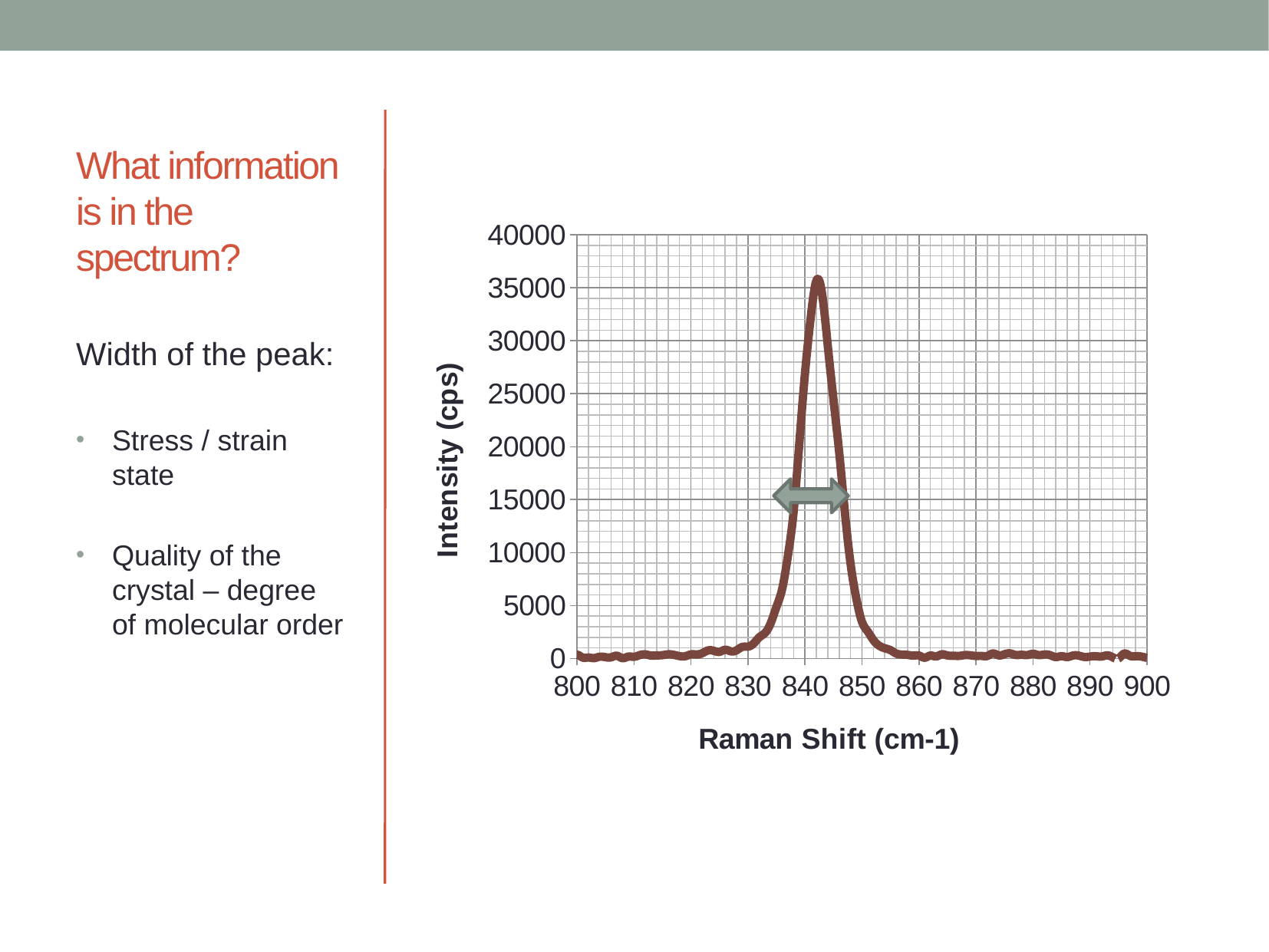
What is the label of the y axis of the chart? Intensity (cps) Does the intensity rise or fall as the Raman shift goes from 830 to 840? rise What is the highest value shown on the y axis? 40000 How many labelled tick marks are on the x axis? 11 Between which two labelled x-axis ticks does the peak of the spectrum lie? 840 and 850 Is the intensity at a Raman shift of 800 greater or less than 5000? less Is the intensity at a Raman shift of 820 greater or less than 10000? less What kind of chart is shown on the slide? line chart What is the label of the x axis of the chart? Raman Shift (cm-1) Is the maximum intensity of the peak greater or less than 30000? greater Does the intensity rise or fall as the Raman shift goes from 850 to 860? fall